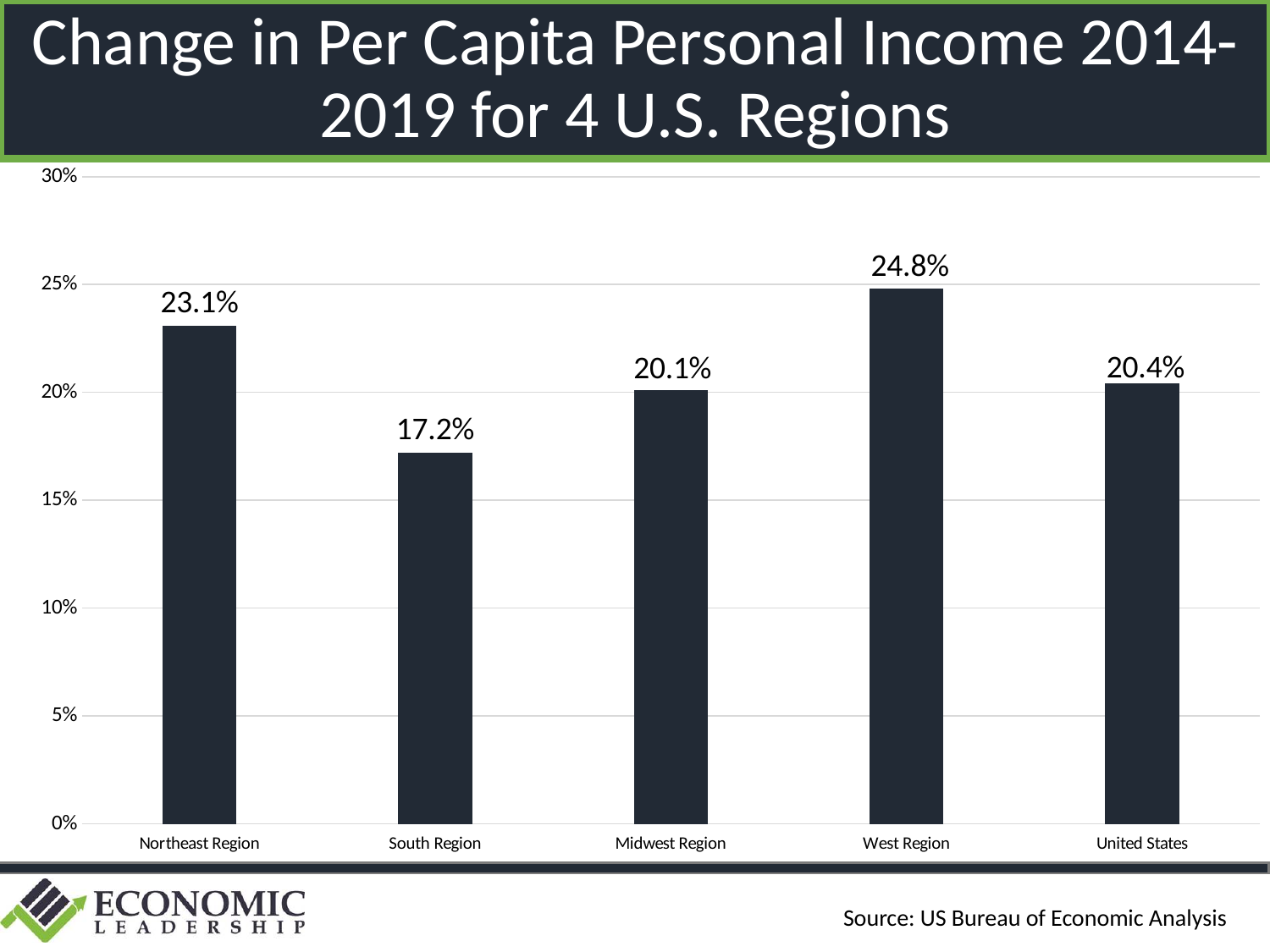
Which region has the highest change in per capita personal income? West Region What is the change in per capita personal income for the South Region? 17.2% What is the difference between the West Region and the South Region values? 7.6% What is the value shown for the United States? 20.4% Which region has the lowest change in per capita personal income? South Region How many bars are shown in the chart? 5 What is the difference between the Northeast Region and the United States values? 2.7% What kind of chart is shown on the slide? Bar chart What is the change in per capita personal income for the Northeast Region? 23.1% What source is cited for the chart data? US Bureau of Economic Analysis Is the value for the South Region greater or less than 20%? less Which is larger, the value for the Midwest Region or the Northeast Region? Northeast Region